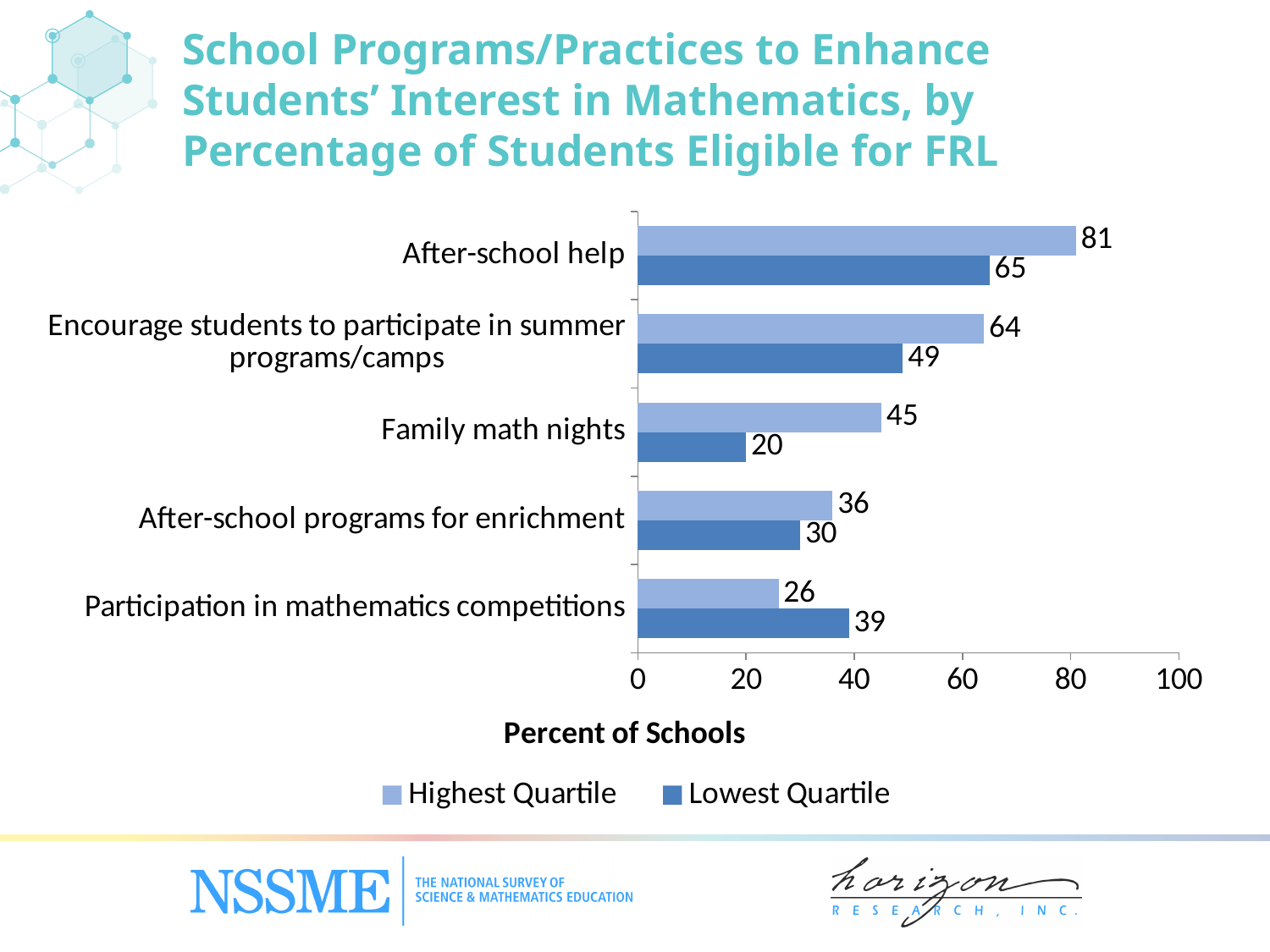
What kind of chart is shown on the slide? Bar chart For Participation in mathematics competitions, which is larger: the Highest Quartile value or the Lowest Quartile value? Lowest Quartile What is the difference between the Highest Quartile and Lowest Quartile values for Family math nights? 25 What is the Lowest Quartile value for Participation in mathematics competitions? 39 What is the label of the x axis? Percent of Schools How many categories are shown on the chart? 5 What is the Lowest Quartile value for Family math nights? 20 Which category has the highest Highest Quartile value? After-school help What is the Highest Quartile value for After-school help? 81 How many series does the legend list? 2 Which category has the lowest Lowest Quartile value? Family math nights What is the difference between the Highest Quartile and Lowest Quartile values for Encourage students to participate in summer programs/camps? 15